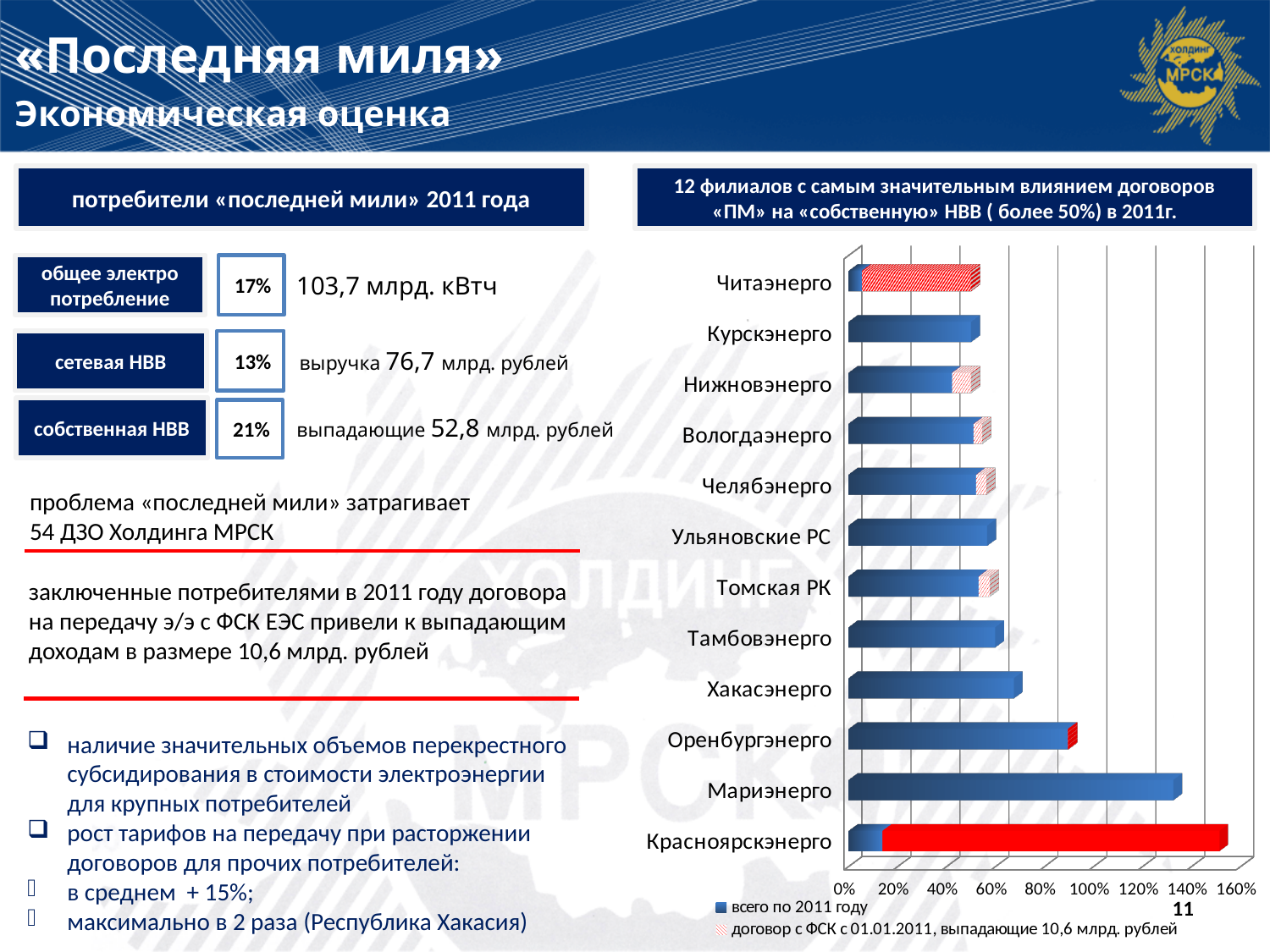
Which has the larger value, Мариэнерго or Хакасэнерго? Мариэнерго Which branch has the longest bar in the chart? Красноярскэнерго Is the value for Оренбургэнерго greater or less than 80%? greater Is the value for Красноярскэнерго greater or less than 140%? greater Is the value for Мариэнерго greater or less than 120%? greater How many branches (categories) are plotted in the chart? 12 What is the first series listed in the chart legend? всего по 2011 году What kind of chart is shown on the slide? bar chart Which has the larger value, Красноярскэнерго or Оренбургэнерго? Красноярскэнерго Which branch is listed at the top of the chart? Читаэнерго How many series does the chart legend list? 2